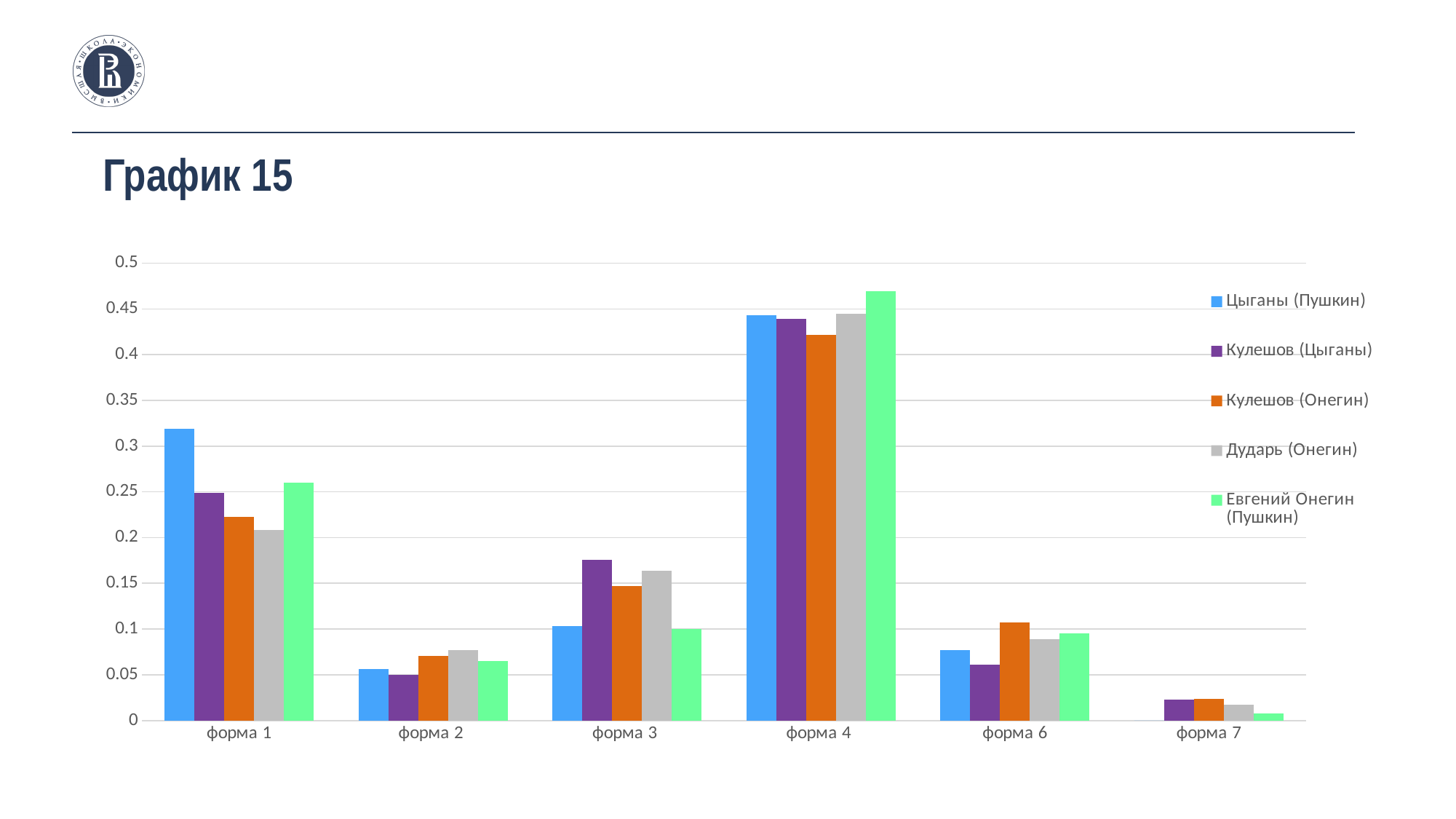
What colour represents the series Евгений Онегин (Пушкин)? green Is the value for Кулешов (Онегин) at форма 4 greater or less than 0.4? greater At форма 3, which is larger: Кулешов (Цыганы) or Цыганы (Пушкин)? Кулешов (Цыганы) For the series Цыганы (Пушкин), which category has the highest value? форма 4 For the series Евгений Онегин (Пушкин), which category has the lowest value? форма 7 Is the value for Цыганы (Пушкин) at форма 1 greater or less than 0.3? greater At форма 6, which is larger: Кулешов (Онегин) or Кулешов (Цыганы)? Кулешов (Онегин) How many series does the legend list? 5 What kind of chart is shown on the slide? bar chart Is the value for Дударь (Онегин) at форма 1 greater or less than 0.25? less How many categories are shown on the x axis? 6 What is the title of the slide? График 15